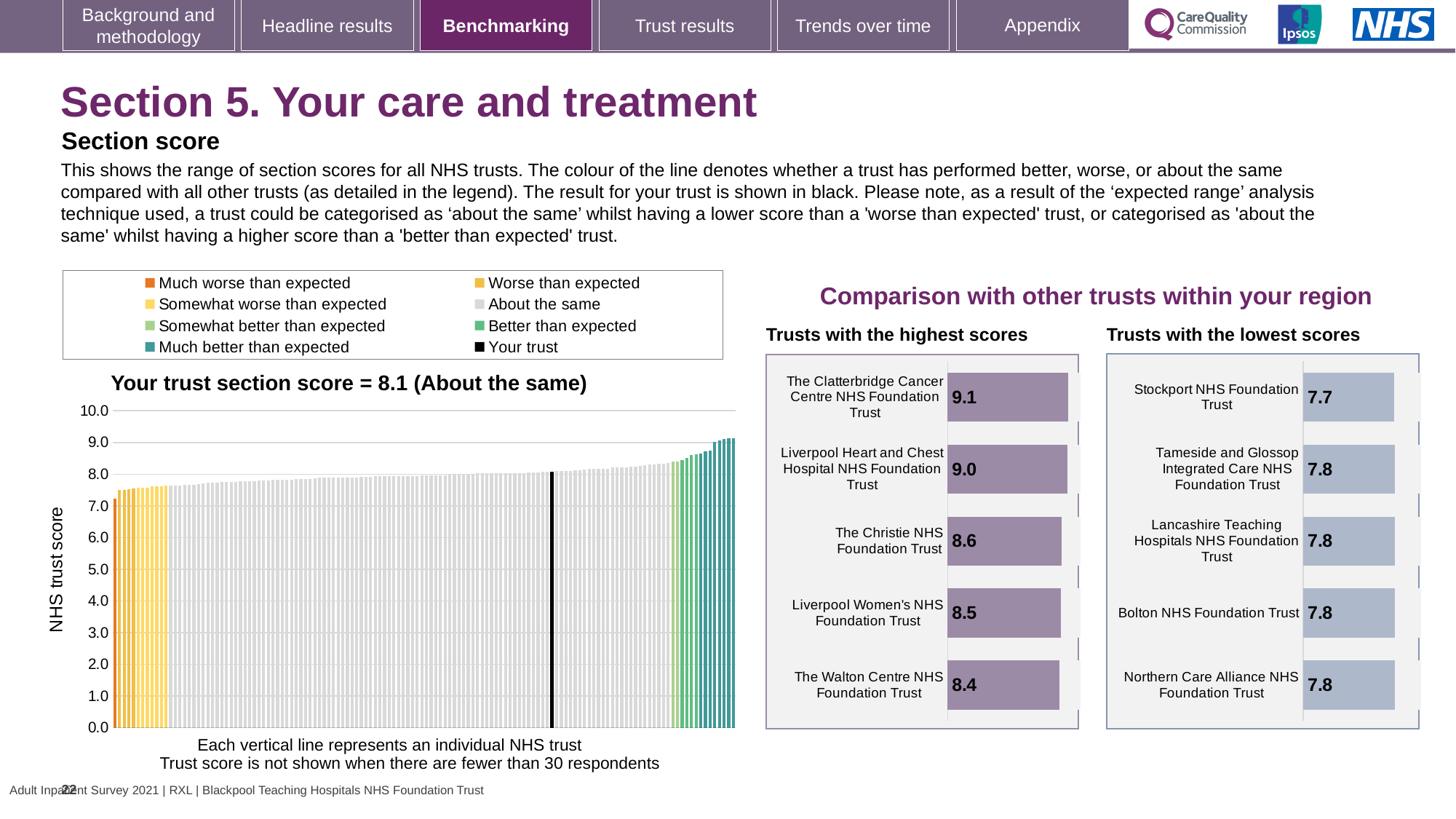
How many trusts are shown in the 'Trusts with the lowest scores' chart? 5 What kind of chart is the main chart on the left showing the range of section scores? Bar chart In the 'Trusts with the lowest scores' chart, which trust has the lowest score? Stockport NHS Foundation Trust Which is larger: the score for Liverpool Women's NHS Foundation Trust in the 'Trusts with the highest scores' chart or the score for Bolton NHS Foundation Trust in the 'Trusts with the lowest scores' chart? Liverpool Women's NHS Foundation Trust In the 'Trusts with the lowest scores' chart, what is the score for Stockport NHS Foundation Trust? 7.7 In the 'Trusts with the highest scores' chart, what is the score for The Clatterbridge Cancer Centre NHS Foundation Trust? 9.1 In the 'Trusts with the highest scores' chart, which trust has the highest score? The Clatterbridge Cancer Centre NHS Foundation Trust In the main chart on the left, what is the section score for your trust? 8.1 In the main chart on the left, do the trust scores rise or fall from left to right? Rise In the 'Trusts with the highest scores' chart, what is the difference between the scores of The Clatterbridge Cancer Centre NHS Foundation Trust and The Walton Centre NHS Foundation Trust? 0.7 In the 'Trusts with the highest scores' chart, what is the score for The Christie NHS Foundation Trust? 8.6 How many entries does the legend above the main chart on the left list? 8